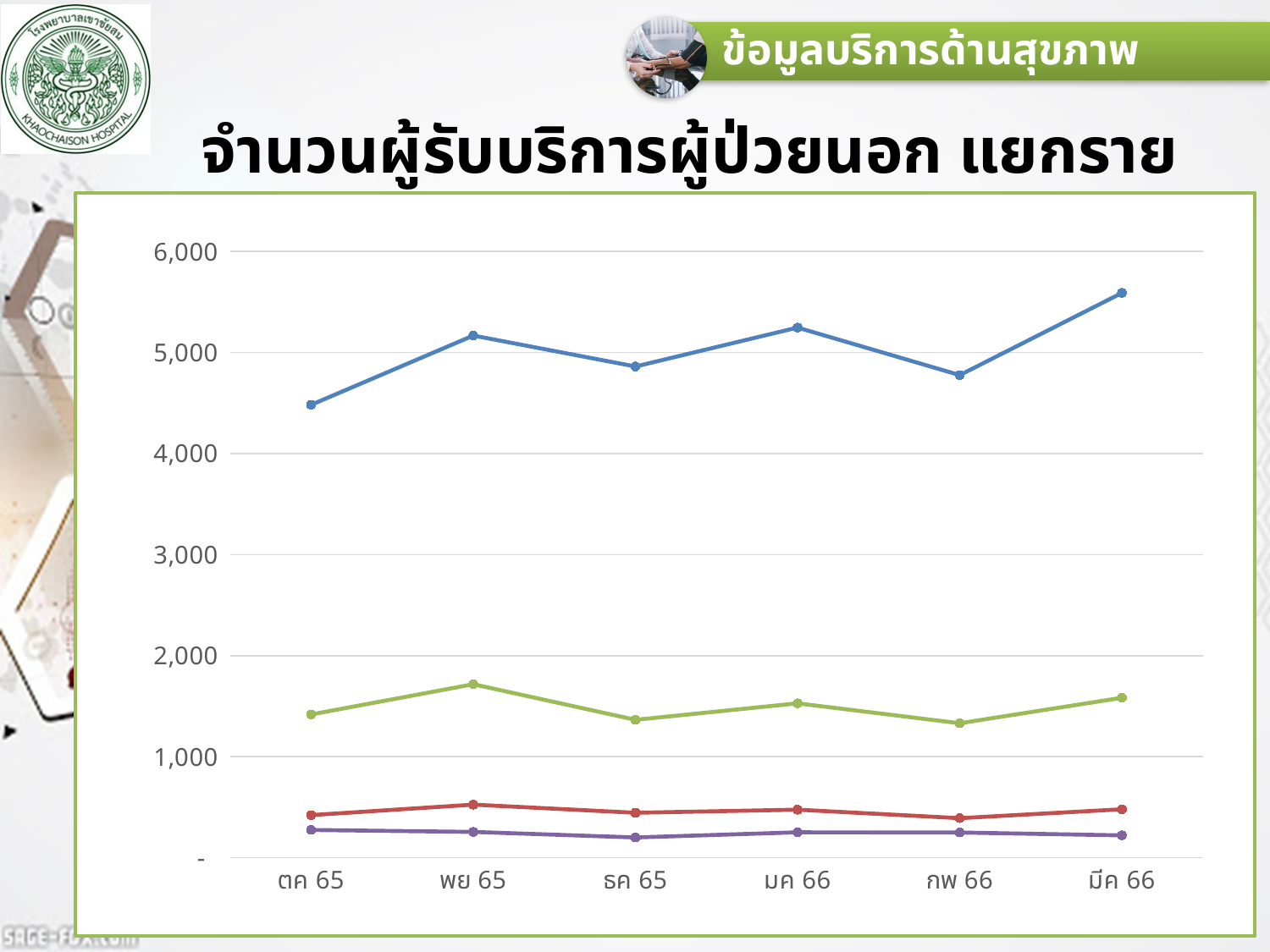
Which line is higher at มค 66, the blue line or the green line? blue line Is the value of the blue line for มีค 66 greater or less than 5,000? greater Is the value of the blue line for ตค 65 greater or less than 5,000? less Which month has the highest value on the blue line? มีค 66 Which month has the lowest value on the blue line? ตค 65 What kind of chart is shown on the slide? line chart Is the value of the red line for พย 65 greater or less than 1,000? less How many points (months) are plotted along the x axis? 6 Does the blue line end higher or lower at มีค 66 than it started at ตค 65? higher How many lines are plotted on the chart? 4 Which month has the highest value on the green line? พย 65